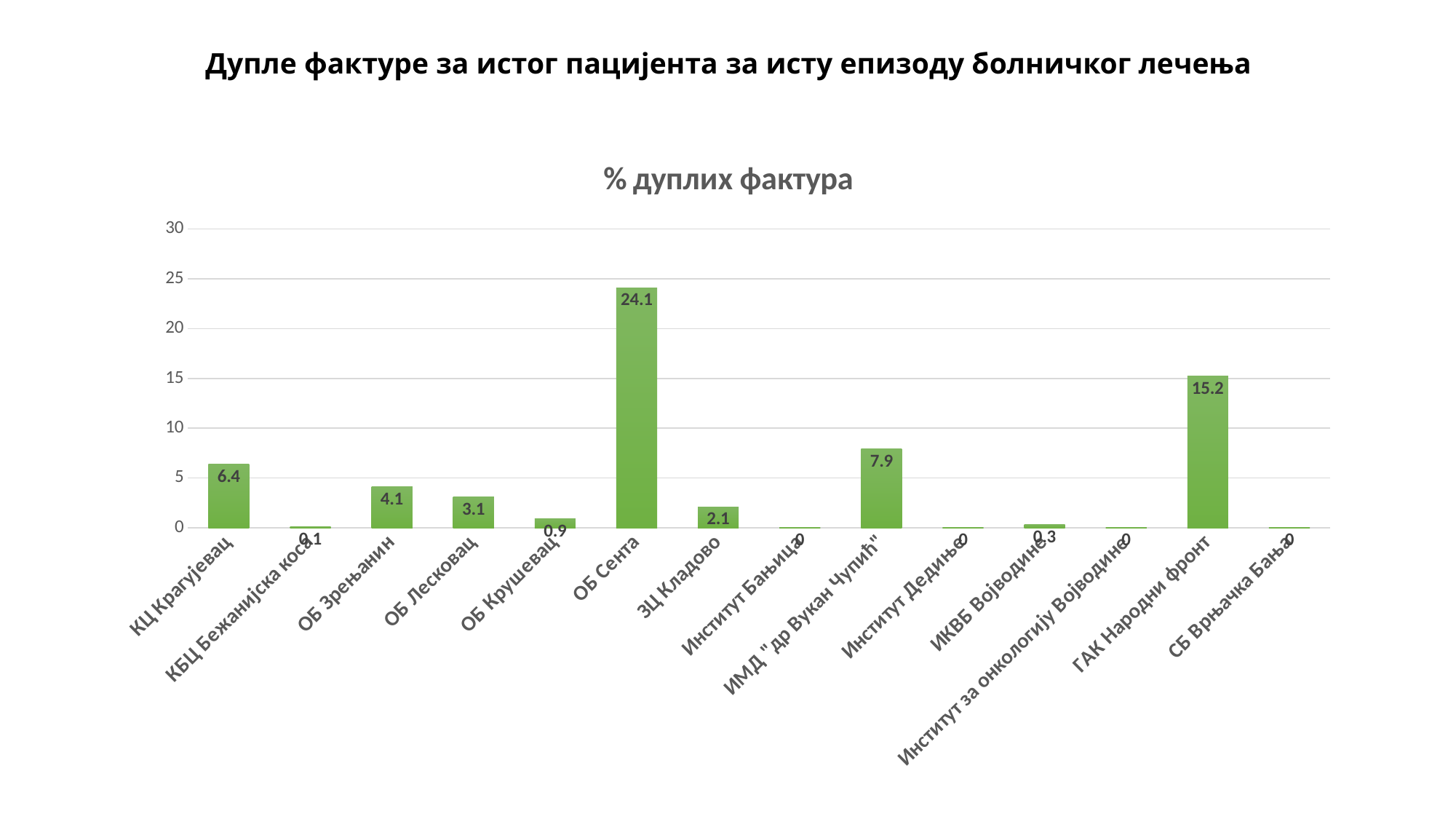
What is the value for ОБ Сента? 24.1 What is the value for КЦ Крагујевац? 6.4 Which category has the highest value? ОБ Сента How many categories are shown on the x axis? 14 What is the value for ЗЦ Кладово? 2.1 What kind of chart is shown on the slide? bar chart What is the value for ИМД "др Вукан Чупић"? 7.9 What is the title of the chart? % дуплих фактура What is the value for ГАК Народни фронт? 15.2 Which is larger, the value for ОБ Зрењанин or the value for ОБ Лесковац? ОБ Зрењанин Is the value for ОБ Сента greater or less than 20? greater What is the difference between the values for ОБ Сента and ГАК Народни фронт? 8.9